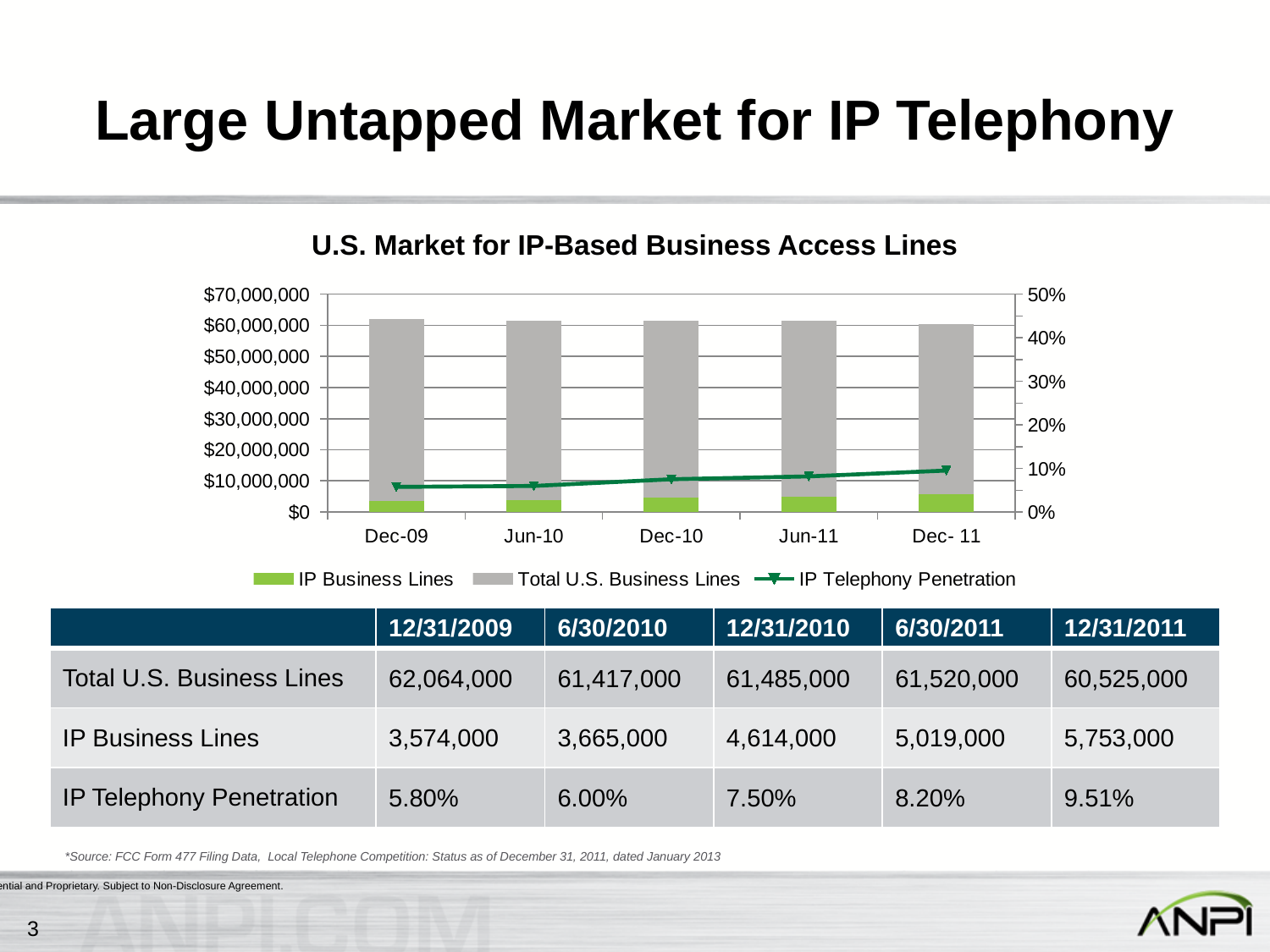
What is the IP Telephony Penetration value for Dec-11 (12/31/2011)? 9.51% What is the difference in IP Business Lines between Dec-11 (5,753,000) and Dec-09 (3,574,000)? 2,179,000 Which is larger: Total U.S. Business Lines in Dec-09 or in Dec-11? Dec-09 What type of chart is used for the IP Business Lines and Total U.S. Business Lines series? Bar chart Which period has the highest IP Telephony Penetration? Dec-11 Which period has the lowest number of IP Business Lines? Dec-09 What is the number of Total U.S. Business Lines for Jun-11 (6/30/2011)? 61,520,000 What is the number of IP Business Lines for Dec-09 (12/31/2009)? 3,574,000 Does IP Telephony Penetration rise or fall from Dec-09 to Dec-11? Rise What is the title of the chart? U.S. Market for IP-Based Business Access Lines How many time periods are shown on the x axis of the chart? 5 How many series does the chart legend list? 3